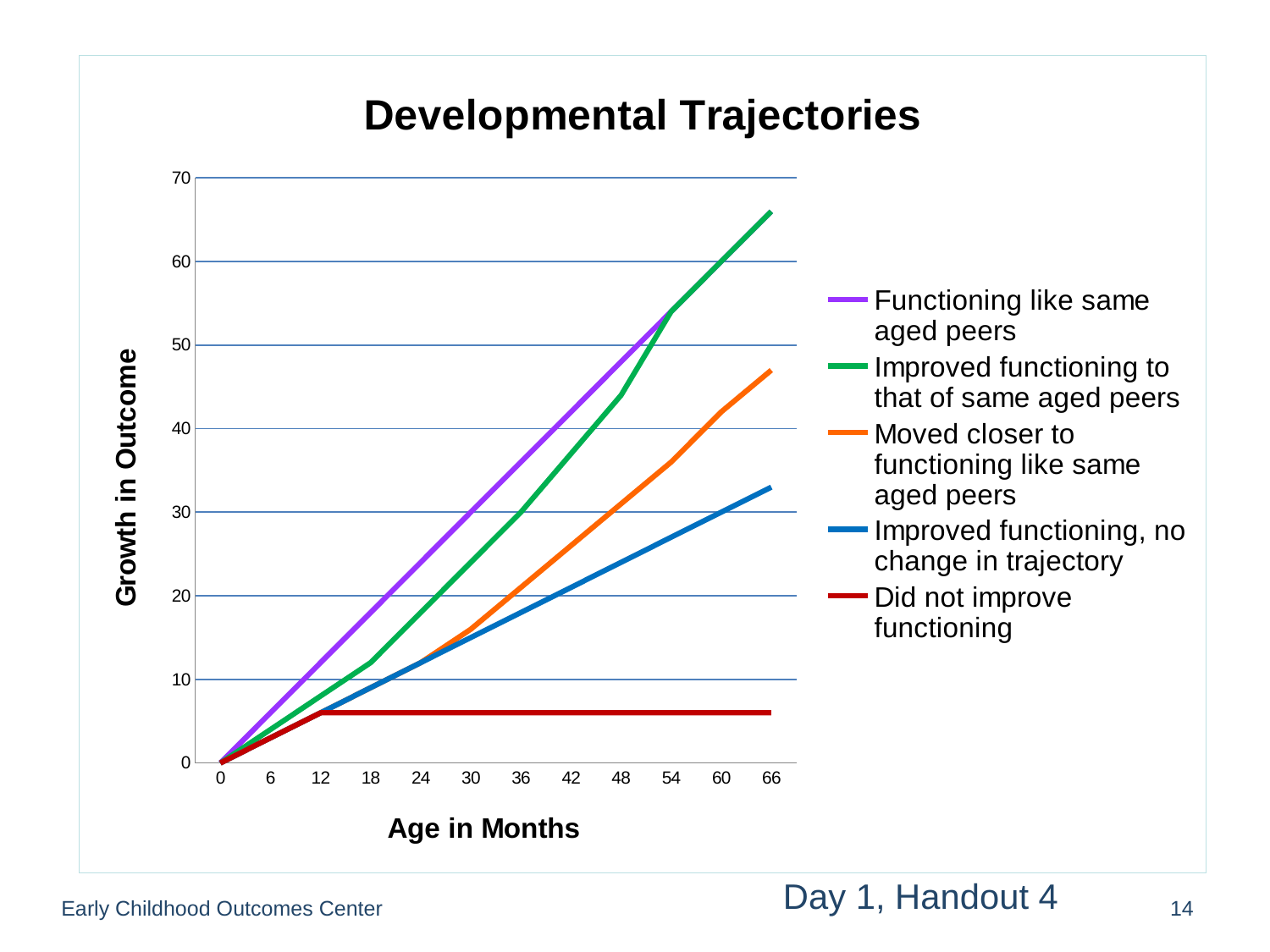
Is the value for 'Improved functioning to that of same aged peers' at 66 months greater or less than 60? greater How many series does the legend list? 5 What is the title of the chart? Developmental Trajectories Is the value for 'Did not improve functioning' at 66 months greater or less than 10? less At 66 months, which is larger: 'Improved functioning, no change in trajectory' or 'Did not improve functioning'? Improved functioning, no change in trajectory Which series has the lowest value at 66 months? Did not improve functioning Is the value for 'Moved closer to functioning like same aged peers' at 66 months greater or less than 50? less What kind of chart is shown on the slide? line chart How many age tick marks are shown along the x axis? 12 What is the label of the x axis? Age in Months Does the 'Did not improve functioning' line rise, fall, or stay flat between 12 and 66 months? stays flat